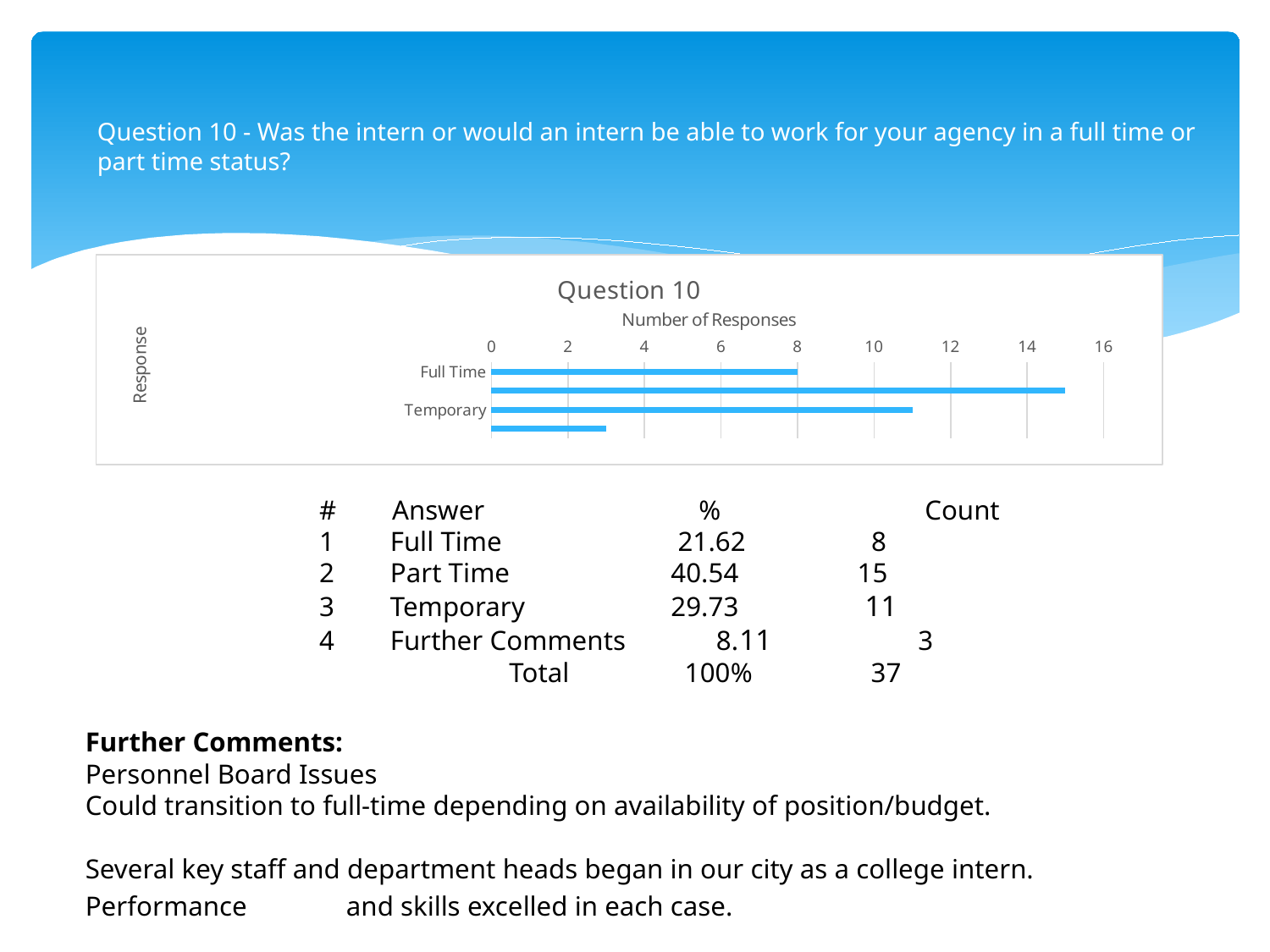
Is the value for Full Time greater or less than 10? less Is the value for Full Time greater or less than 6? greater What type of chart is shown on the slide? bar chart What is the difference in responses between Temporary and Full Time? 3 What is the label on the horizontal axis of the chart? Number of Responses What is the number of responses for Full Time in the chart? 8 Is the value for Temporary greater or less than 10? greater What is the title of the chart? Question 10 What is the number of responses for Temporary in the chart? 11 Which has more responses in the chart, Full Time or Temporary? Temporary How many bars are plotted in the chart? 4